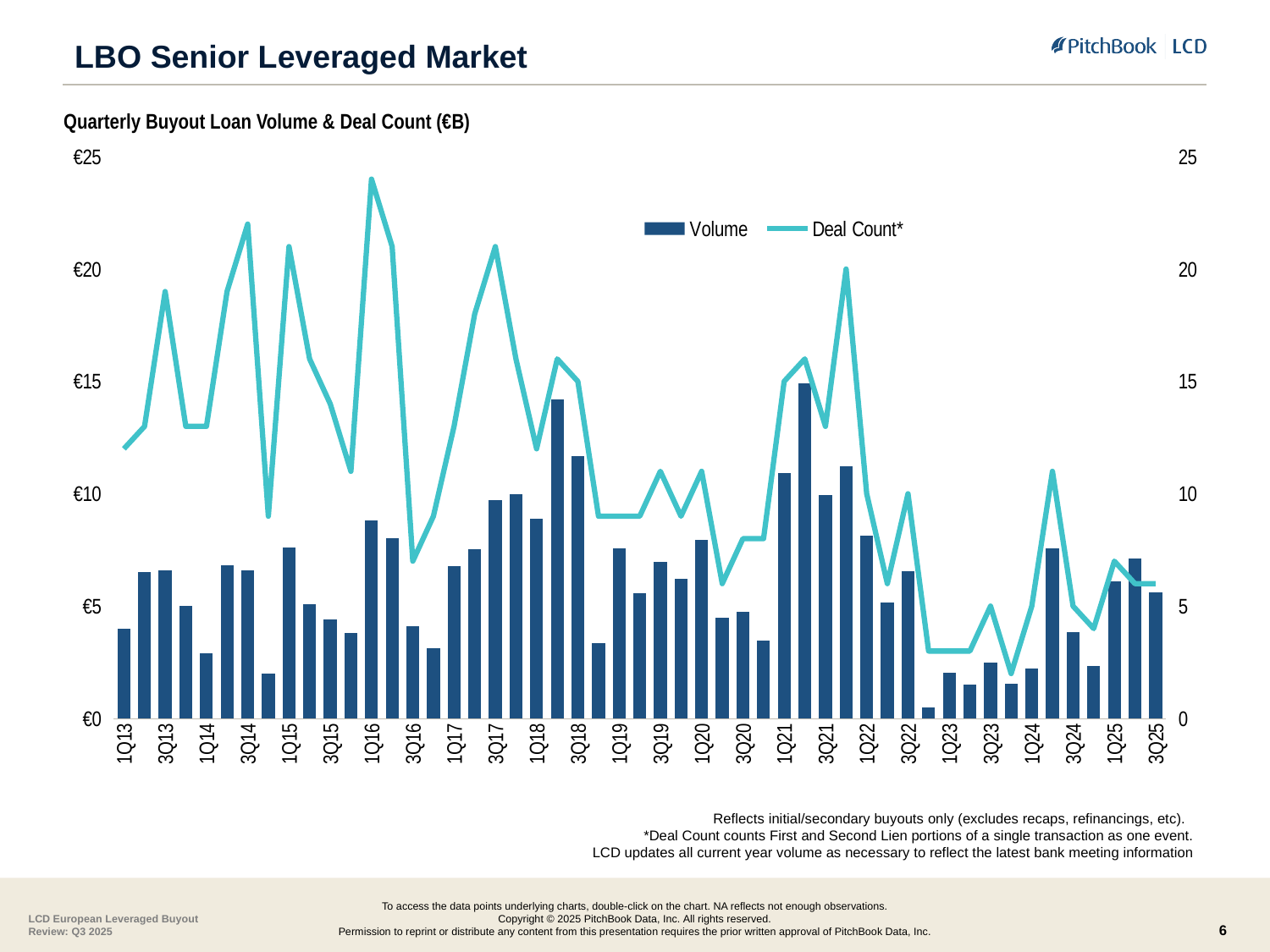
In which quarter does the Deal Count line reach its highest point? 1Q16 How many series does the legend list? 2 Is the Deal Count for 1Q16 greater or less than 20? greater Which quarter has the larger Volume, 1Q21 or 3Q21? 1Q21 In which quarter is the Volume bar highest? 2Q21 What is the title of the chart? Quarterly Buyout Loan Volume & Deal Count (€B) Which series is drawn as a line? Deal Count* Is the Volume for 3Q22 greater or less than €5? greater What kind of chart is this? Combined bar and line chart In which quarter is the Volume bar lowest? 4Q22 Is the Deal Count for 1Q23 greater or less than 5? less